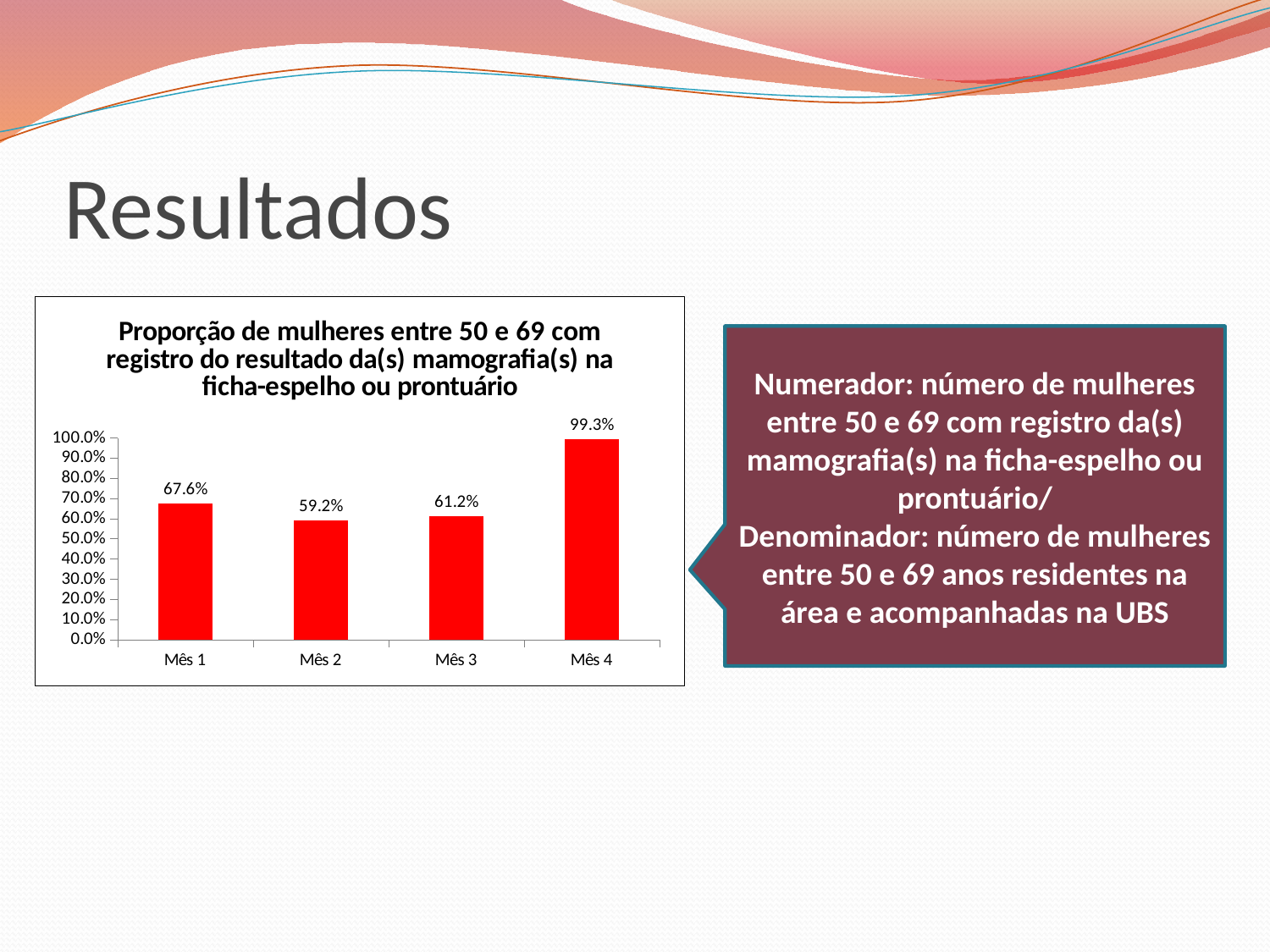
What kind of chart is shown on the slide? bar chart Is the value for Mês 4 greater or less than 90.0%? greater Which is larger, the value for Mês 1 or the value for Mês 3? Mês 1 How many months are shown on the x axis? 4 What is the value for Mês 1? 67.6% What is the value for Mês 3? 61.2% Which month has the lowest value? Mês 2 What is the value for Mês 2? 59.2% What colour are the bars in the chart? red What is the value for Mês 4? 99.3% What is the difference between the values for Mês 4 and Mês 1? 31.7% Which month has the highest value? Mês 4